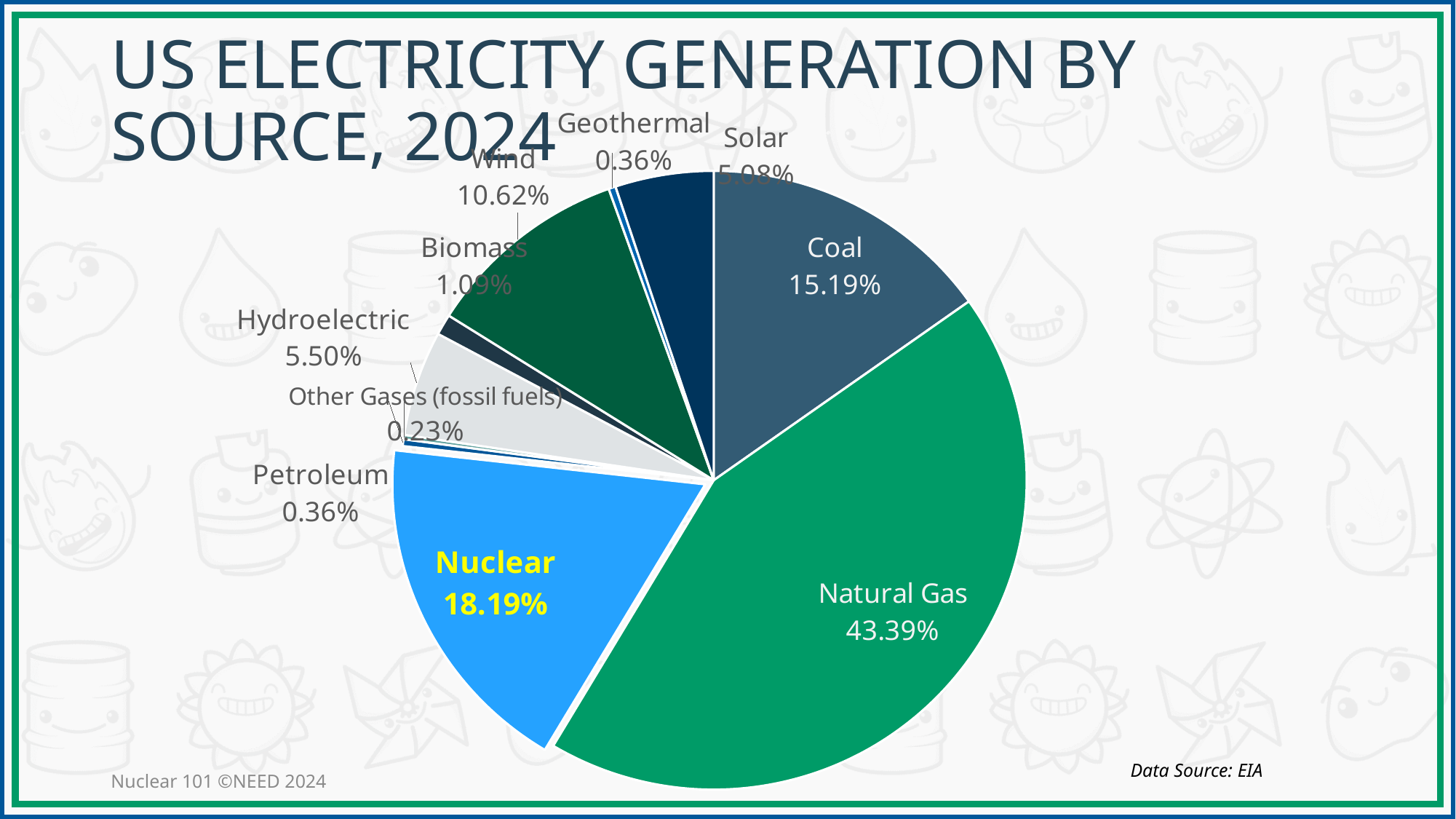
Which source has the smallest slice of the pie? Other Gases (fossil fuels) How many sources (slices) are shown in the pie chart? 10 What is the difference in percentage points between Natural Gas and Nuclear? 25.20 percentage points What type of chart is shown on the slide? Pie chart What is the title of the chart? US ELECTRICITY GENERATION BY SOURCE, 2024 What percentage is shown for Nuclear? 18.19% Which is larger, the share for Hydroelectric or the share for Solar? Hydroelectric What is the difference in percentage points between Nuclear and Coal? 3.00 percentage points Which source has the largest slice of the pie? Natural Gas What percentage is shown for Coal? 15.19% What share of US electricity generation in 2024 came from Natural Gas? 43.39% What percentage is shown for Wind? 10.62%